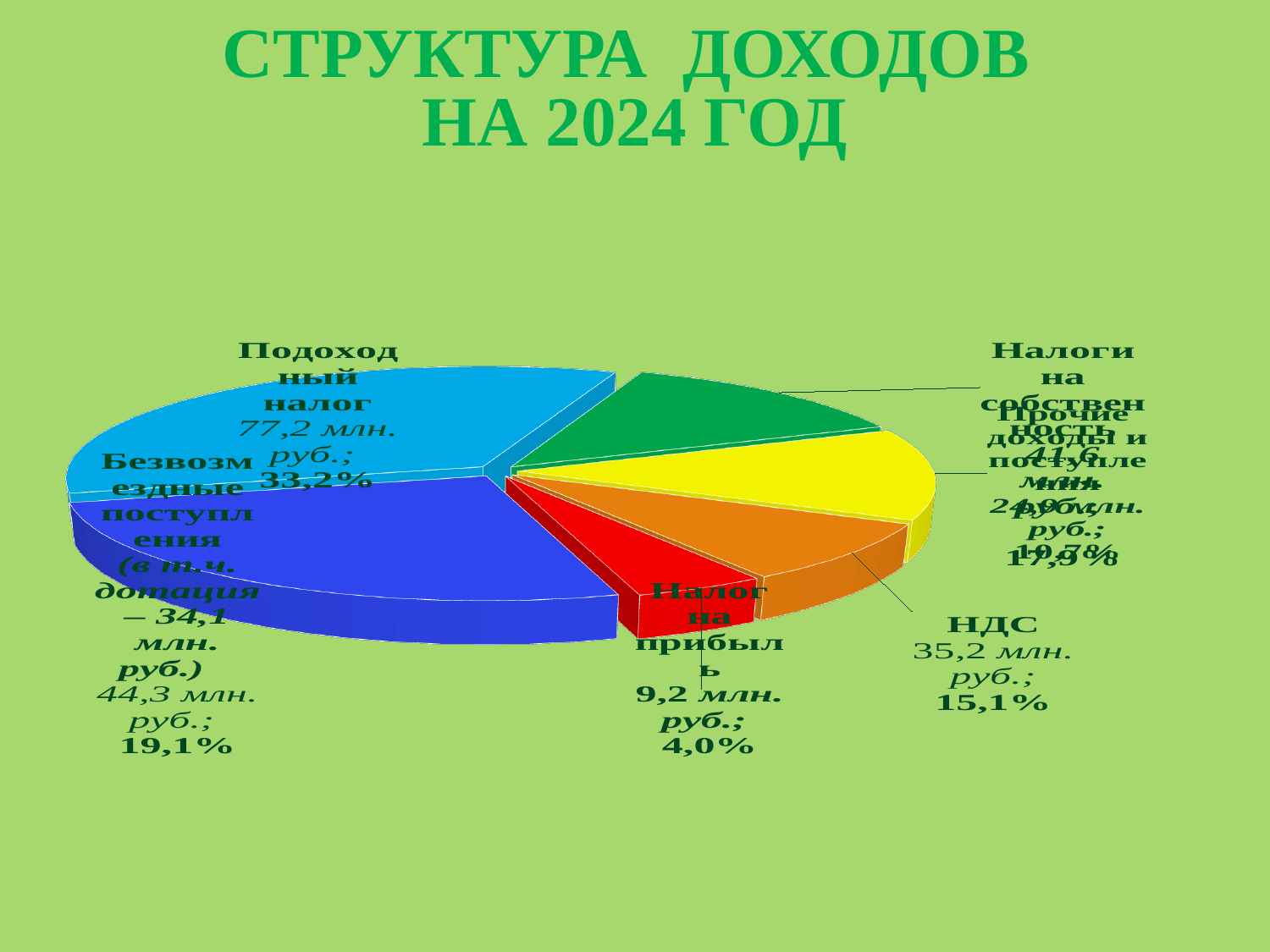
What kind of chart is shown on the slide? pie chart Which is larger, НДС or Безвозмездные поступления? Безвозмездные поступления What is the value shown for НДС? 35,2 млн. руб. Which category has the smallest slice of the pie? Налог на прибыль What is the title of the chart on the slide? СТРУКТУРА ДОХОДОВ НА 2024 ГОД What percentage is shown for Безвозмездные поступления? 19,1% What percentage is shown for Налог на прибыль? 4,0% What share of the pie does Подоходный налог account for? 33,2% Which category has the largest slice of the pie? Подоходный налог What is the value shown for Безвозмездные поступления? 44,3 млн. руб. What is the difference between the values for Подоходный налог and НДС? 42,0 млн. руб. How many slices does the pie chart have? 6